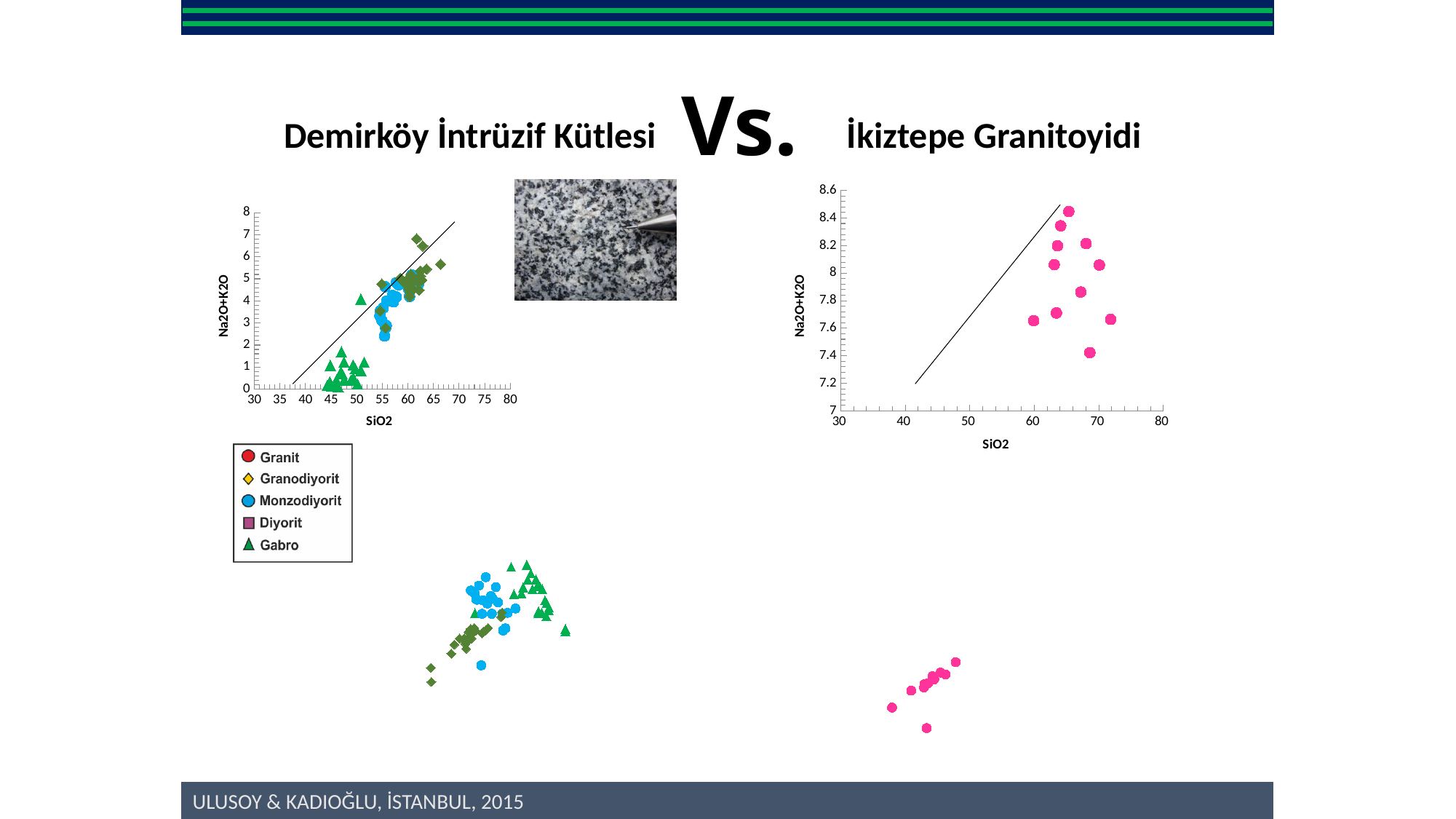
How many entries does the legend below the Demirköy İntrüzif Kütlesi chart list? 5 On the İkiztepe Granitoyidi chart, what is the label of the y axis? Na2O+K2O What is the highest tick value shown on the y axis of the İkiztepe Granitoyidi chart? 8.6 On the Demirköy İntrüzif Kütlesi chart, do the Na2O+K2O values generally rise or fall as SiO2 increases? rise On the İkiztepe Granitoyidi chart, is the Na2O+K2O value of the lowest point greater or less than 7.6? less On the Demirköy İntrüzif Kütlesi chart, which group plots at higher SiO2 values, the Gabro triangles or the Monzodiyorit circles? Monzodiyorit On the İkiztepe Granitoyidi chart, is the Na2O+K2O value of the highest point greater or less than 8.2? greater What kind of chart is the İkiztepe Granitoyidi chart on the right? scatter chart On the Demirköy İntrüzif Kütlesi chart, what is the label of the x axis? SiO2 On the Demirköy İntrüzif Kütlesi chart, are the Na2O+K2O values of most Gabro triangles greater or less than 2? less What kind of chart is the Demirköy İntrüzif Kütlesi chart on the left? scatter chart